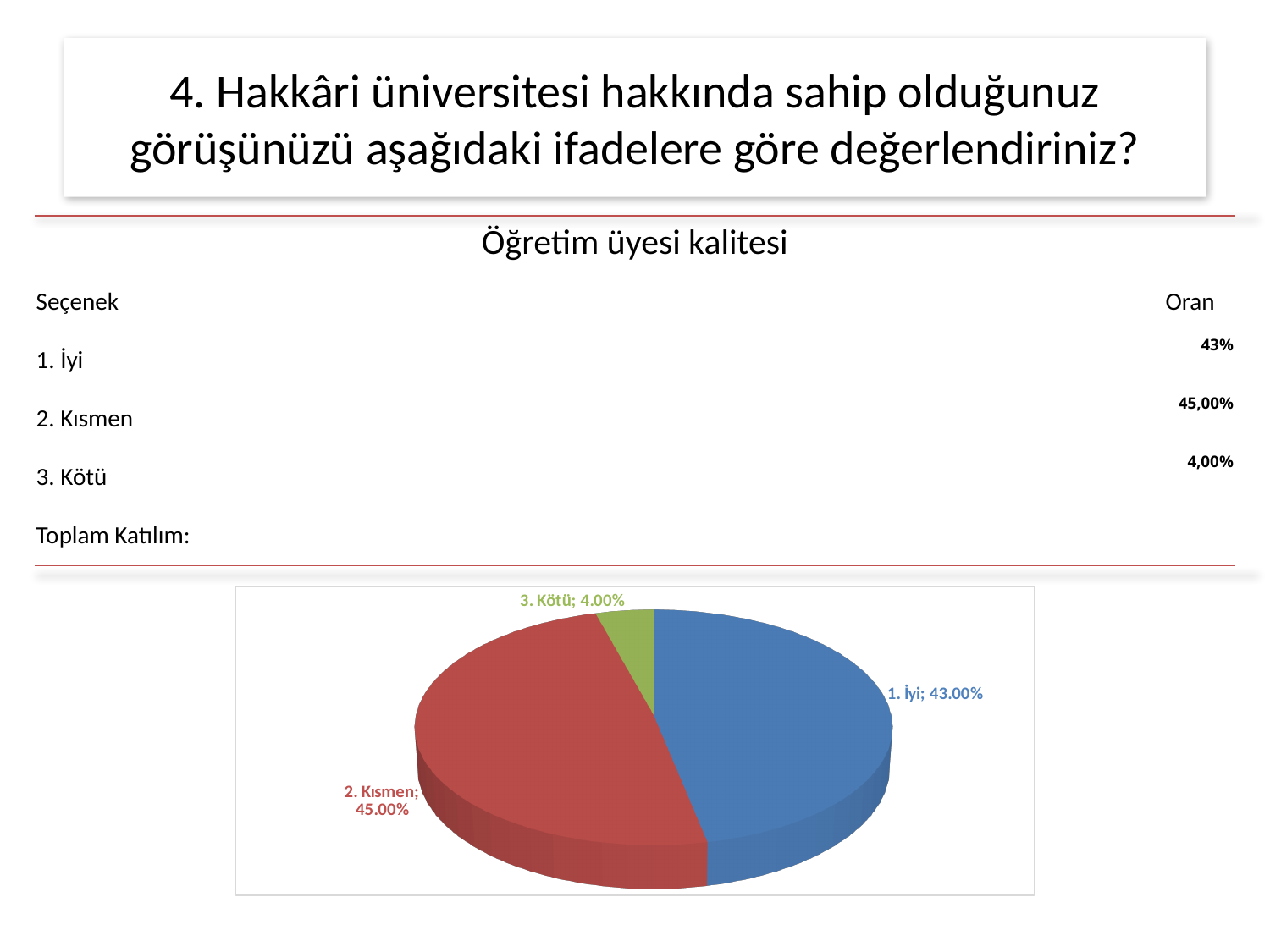
What kind of chart is shown on the slide? Pie chart What is the value shown for the slice labelled "2. Kısmen" in the pie chart? 45.00% What colour is the "2. Kısmen" slice in the pie chart? Red What is the value shown for the slice labelled "3. Kötü" in the pie chart? 4.00% How many slices does the pie chart have? 3 What is the value shown for the slice labelled "1. İyi" in the pie chart? 43.00% What is the difference between the values for "1. İyi" and "3. Kötü" in the pie chart? 39.00% Which slice of the pie chart has the smallest value? 3. Kötü What share of the pie does the "3. Kötü" slice represent according to its label? 4.00% Which slice of the pie chart has the largest value? 2. Kısmen What is the difference between the values for "2. Kısmen" and "1. İyi" in the pie chart? 2.00% Which is larger in the pie chart, the value for "1. İyi" or the value for "3. Kötü"? 1. İyi